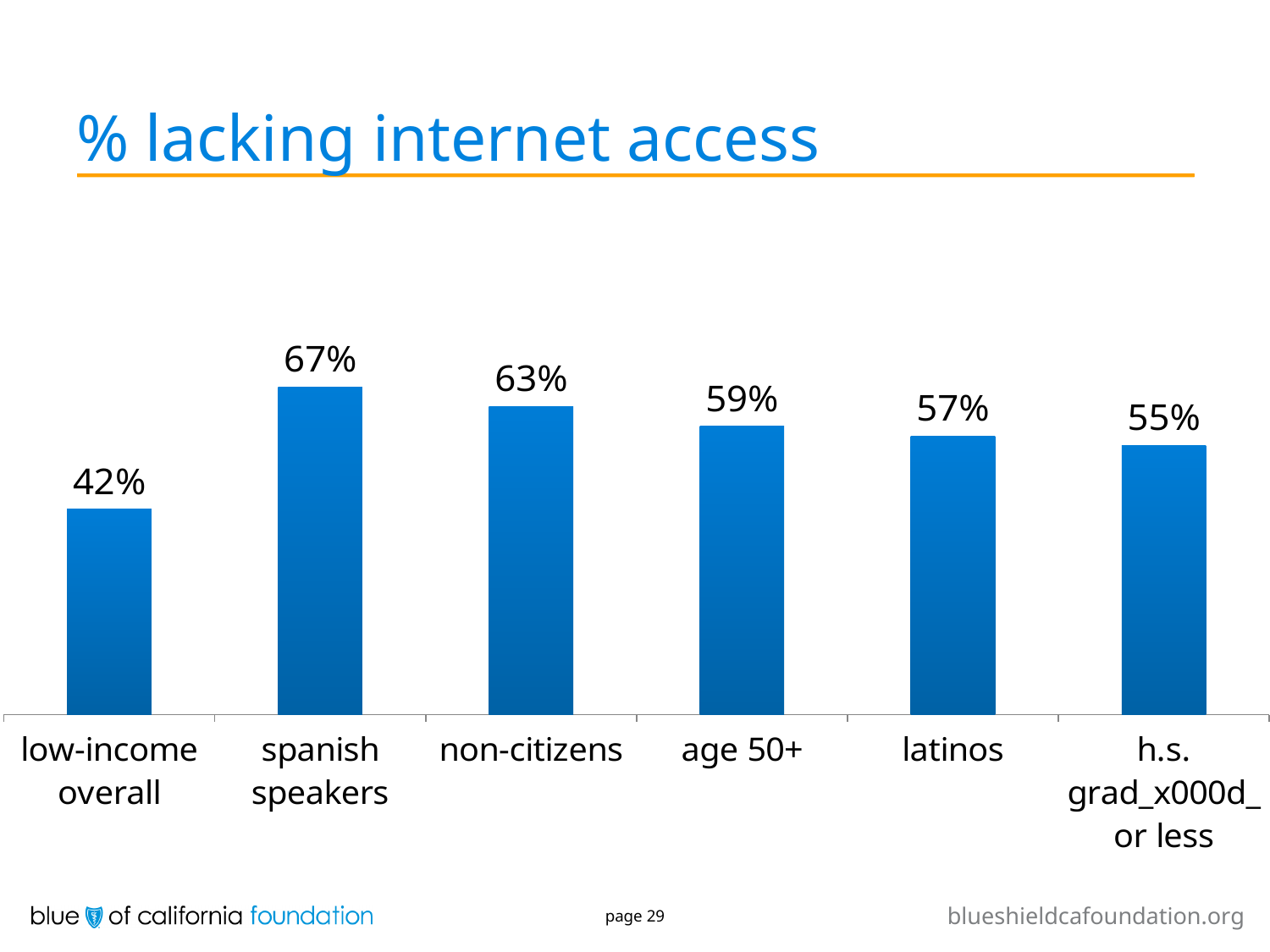
Which category has the lowest value? low-income overall Which is larger, the value for age 50+ or the value for latinos? age 50+ What is the difference between the values for spanish speakers and low-income overall? 25% Which category has the highest value? spanish speakers What is the difference between the values for non-citizens and age 50+? 4% What is the title of the chart? % lacking internet access How many categories are shown in the chart? 6 What kind of chart is shown on the slide? bar chart What is the value for non-citizens? 63% What is the value for spanish speakers? 67% What is the value for latinos? 57% What is the value for low-income overall? 42%